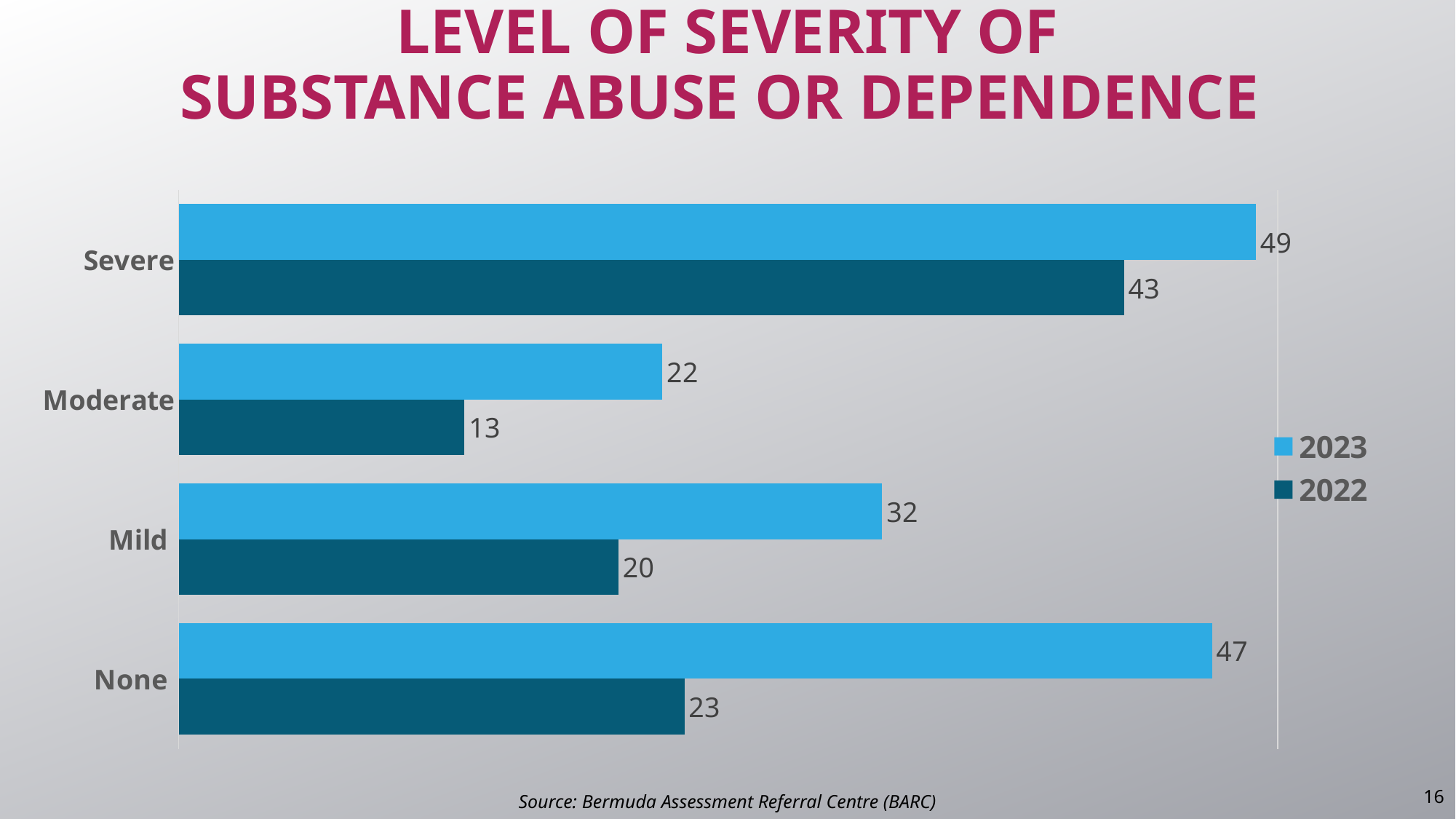
What is the difference between the 2023 and 2022 values for None? 24 How many series does the legend list? 2 Which category has the lowest value in 2022? Moderate What is the value for None in 2023? 47 What is the value for Mild in 2022? 20 What is the difference between the 2023 and 2022 values for Severe? 6 What kind of chart is shown on the slide? Bar chart What is the value for Moderate in 2022? 13 How many severity categories are shown on the chart? 4 Which is larger, the 2023 value for Mild or the 2023 value for Moderate? Mild Which category has the highest value in 2023? Severe What is the value for Severe in 2023? 49